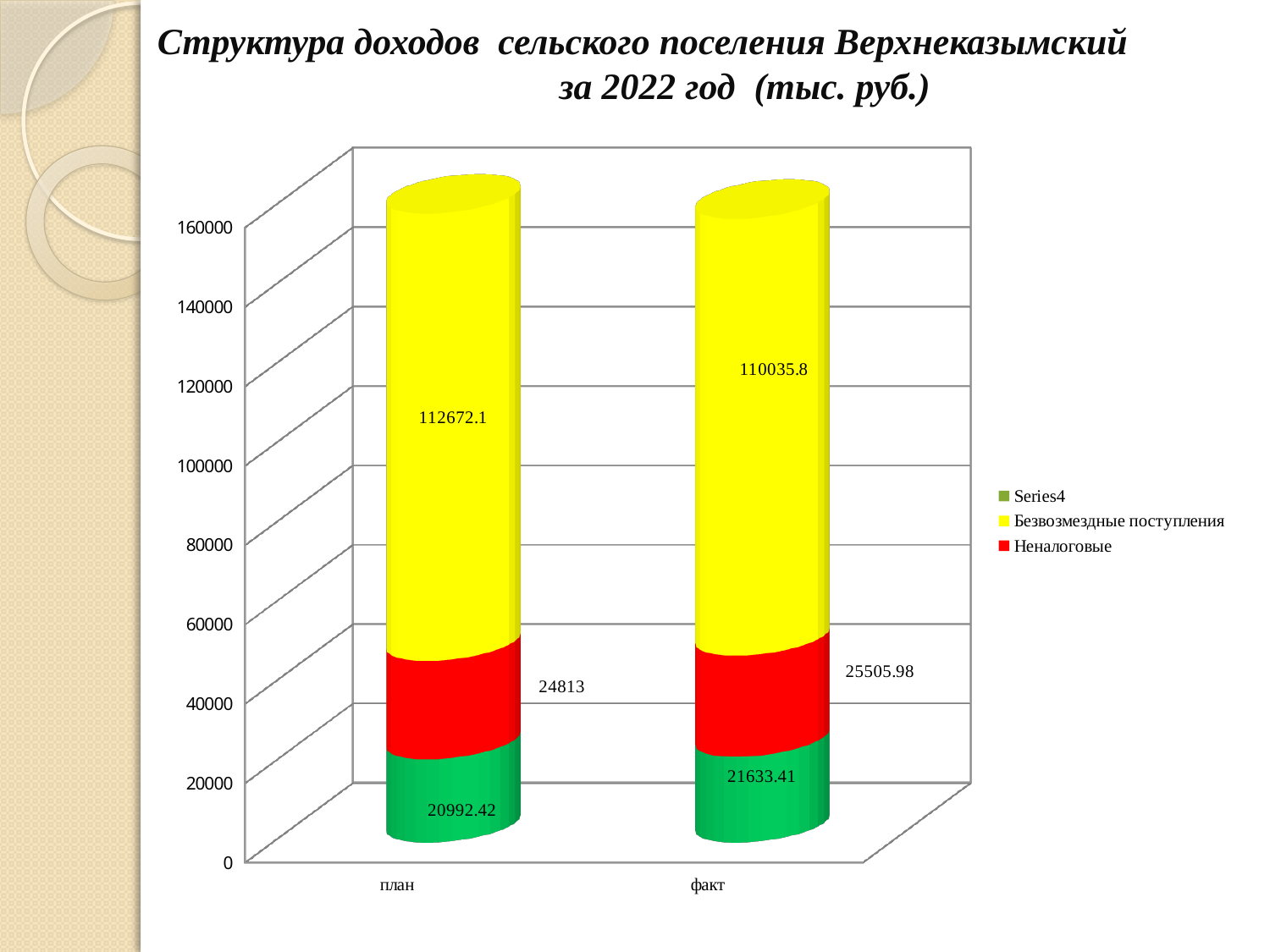
What is the value of Неналоговые for факт? 25505.98 Which is larger, the Безвозмездные поступления value for план or for факт? план What is the difference between the Неналоговые values for факт and план? 692.98 What is the total of the stacked bar for план? 158477.52 How many categories are shown on the x axis? 2 What is the value of Безвозмездные поступления for факт? 110035.8 What kind of chart is shown on the slide? stacked bar chart What is the value of Неналоговые for план? 24813 How many series does the legend list? 3 What is the value of Безвозмездные поступления for план? 112672.1 What is the total of the stacked bar for факт? 157175.19